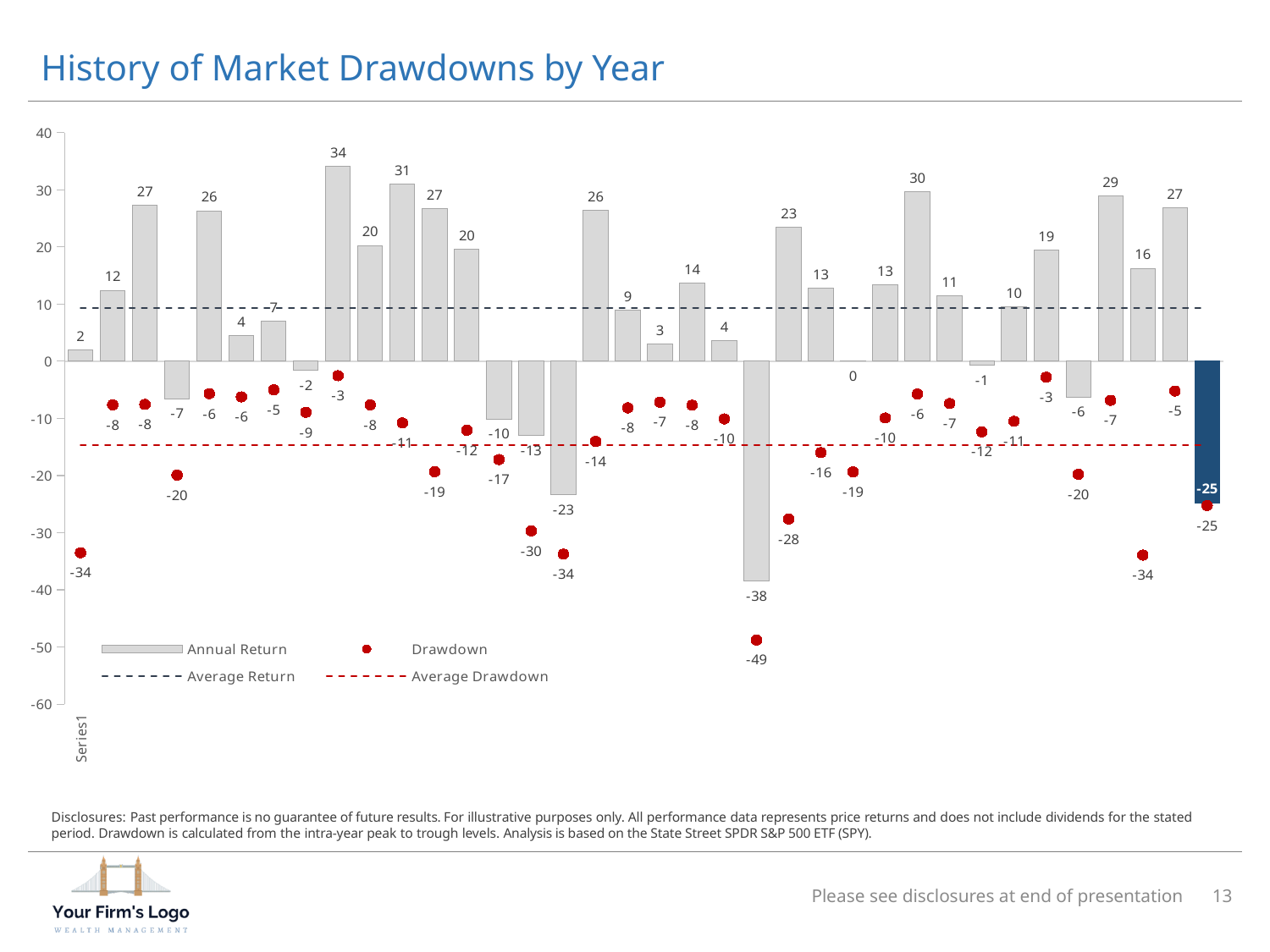
What is the Drawdown value for the last (rightmost) data point on the chart? -25 What is the lowest Annual Return value shown on the chart? -38 Which is larger in magnitude: the highest Annual Return (34) or the largest Drawdown (-49)? The largest Drawdown (-49) What is the Annual Return value of the dark blue bar at the far right of the chart? -25 What kind of chart is used to show the Annual Return series? Bar chart How many entries does the chart legend list? 4 What is the title of the chart? History of Market Drawdowns by Year What is the largest (most negative) Drawdown value shown on the chart? -49 What is the difference between the highest Annual Return (34) and the lowest Annual Return (-38)? 72 What is the highest Annual Return value shown on the chart? 34 What is the smallest (least negative) Drawdown value shown on the chart? -3 Which legend entry is represented by the red dashed line? Average Drawdown